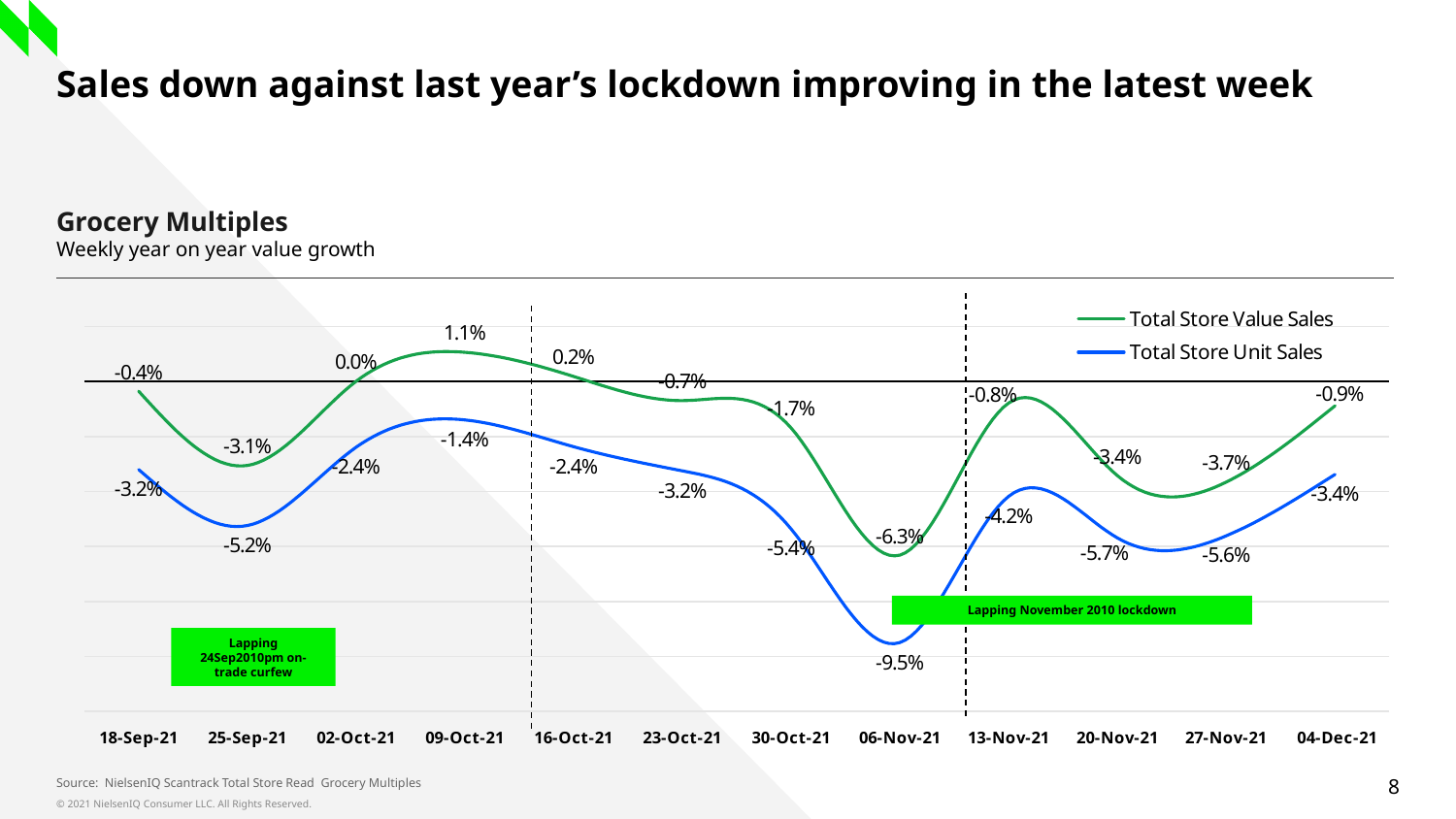
What is the Total Store Value Sales growth for 04-Dec-21? -0.9% Does Total Store Value Sales growth rise or fall from 06-Nov-21 to 13-Nov-21? Rise On which week is Total Store Value Sales growth highest? 09-Oct-21 How many weeks are plotted on the x axis? 12 On which week is Total Store Unit Sales growth lowest? 06-Nov-21 What is the Total Store Value Sales growth for 09-Oct-21? 1.1% What is the Total Store Unit Sales growth for 18-Sep-21? -3.2% What kind of chart is shown on the slide? Line chart On 04-Dec-21, which series has the higher growth, Total Store Value Sales or Total Store Unit Sales? Total Store Value Sales How many series does the legend list? 2 What is the Total Store Unit Sales growth for 06-Nov-21? -9.5% What is the difference between Total Store Value Sales and Total Store Unit Sales growth on 06-Nov-21? 3.2 percentage points